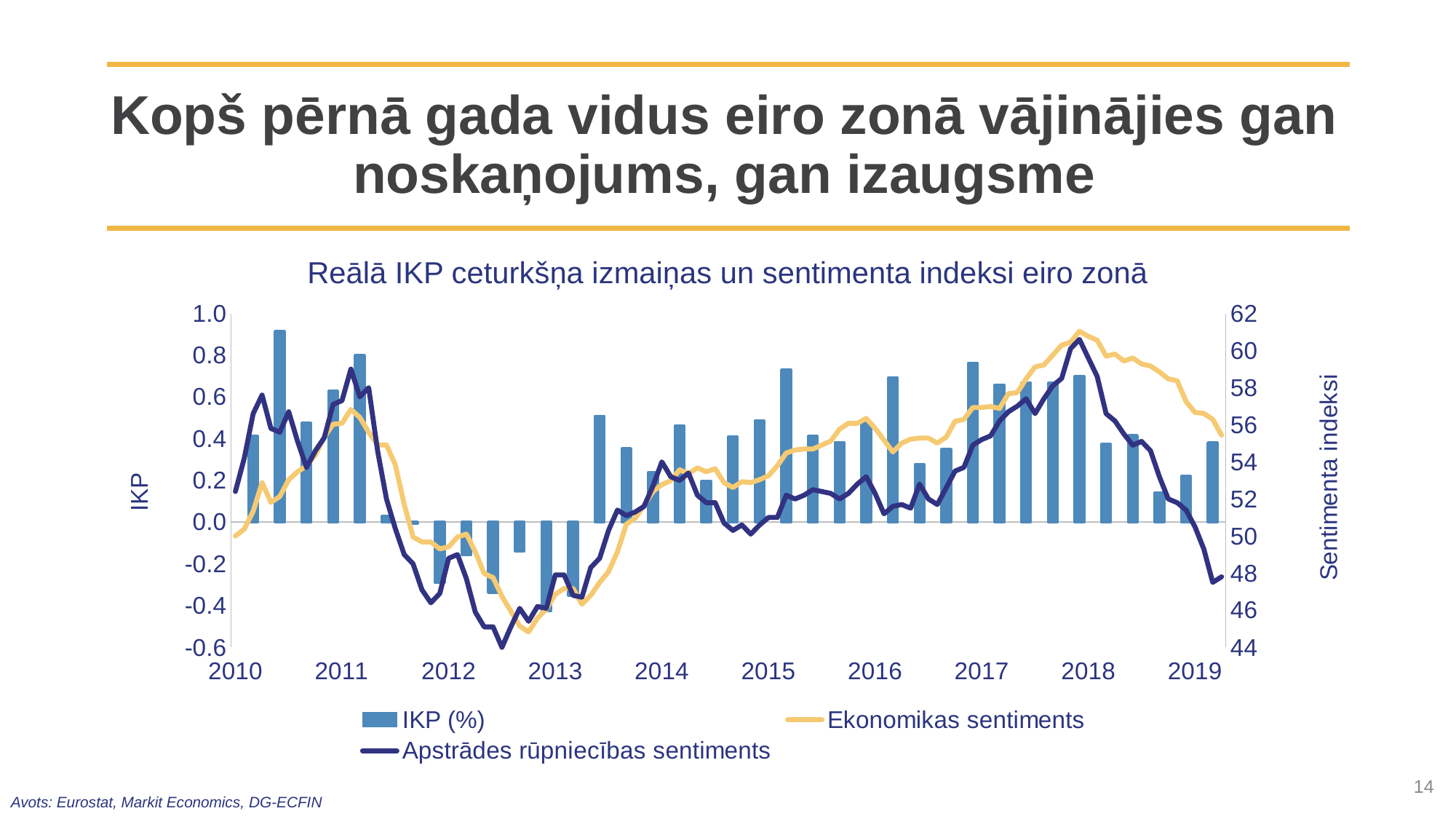
In which year does the tallest IKP (%) bar occur? 2010 Is the value of the Apstrādes rūpniecības sentiments line at the end of 2019 greater or less than 50? less How many year labels are shown on the x axis? 10 What is the highest value shown on the right-hand (Sentimenta indeksi) axis? 62 Is the tallest IKP (%) bar in 2010 greater or less than 0.8? greater Do the sentiment index lines rise or fall between 2013 and 2017? rise Do the sentiment index lines rise or fall between the start of 2018 and 2019? fall Which series is shown as bars in the chart? IKP (%) How many series does the chart legend list? 3 What is the title of the chart? Reālā IKP ceturkšņa izmaiņas un sentimenta indeksi eiro zonā What kind of chart is this? Combined bar and line chart Is the peak of the Ekonomikas sentiments line around the start of 2018 greater or less than 60? greater